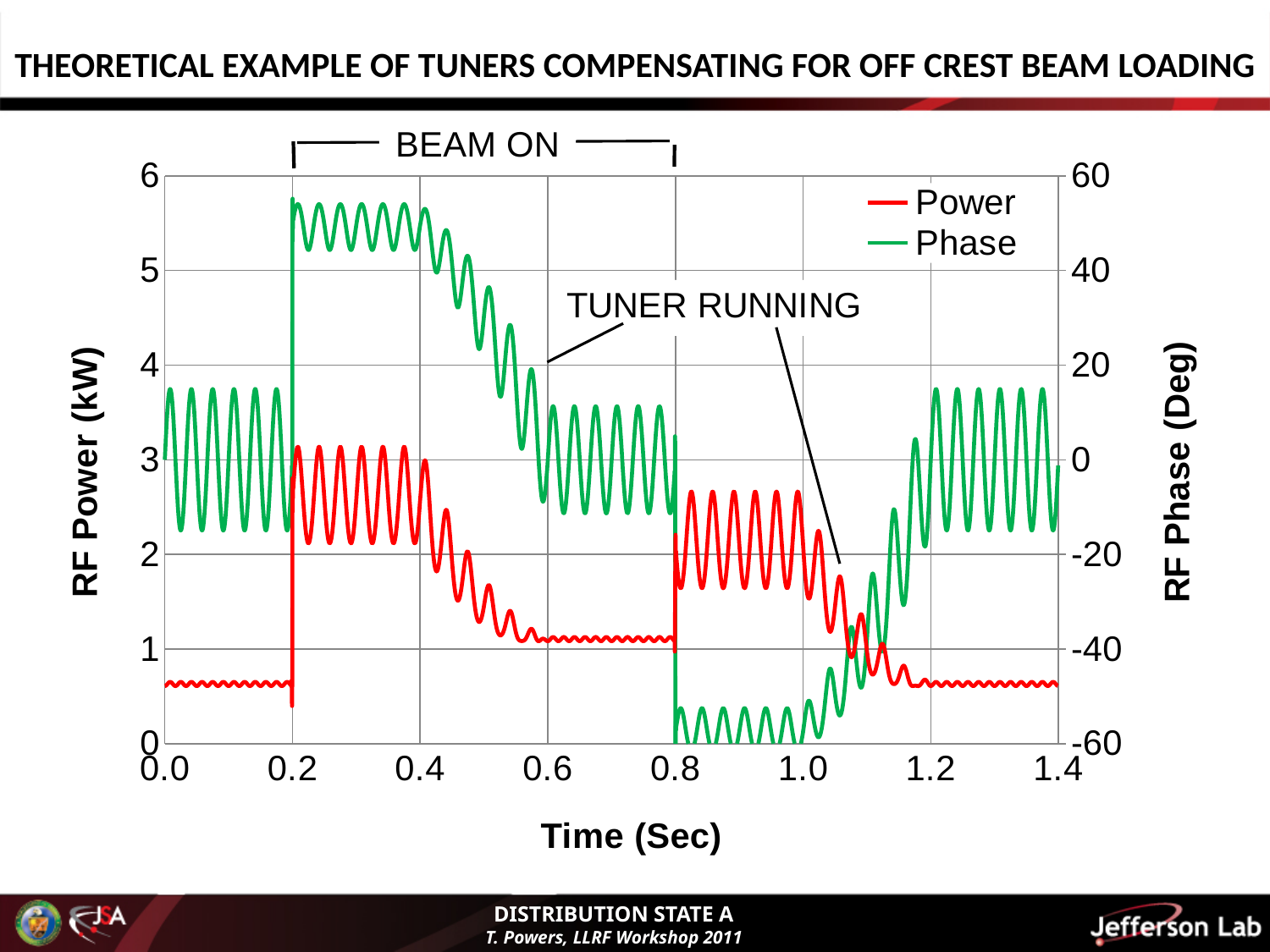
Which series is higher at time 0.3 sec on its own axis scale, Power (kW) or Phase (Deg), in terms of the Power line being above or below the Phase line on the plot? Phase Is the Power value at time 0.3 sec greater or less than 2 kW? greater Is the Phase value at time 0.3 sec greater or less than 40 degrees? greater What kind of chart is shown on the slide? line chart Is the Power value at time 1.3 sec greater or less than 1 kW? less How many series does the legend list? 2 Does the Phase line rise or fall between 1.0 sec and 1.2 sec? rise Does the Power line rise or fall between 0.4 sec and 0.6 sec? fall What are the two series named in the legend? Power and Phase What colour is the Power line? red